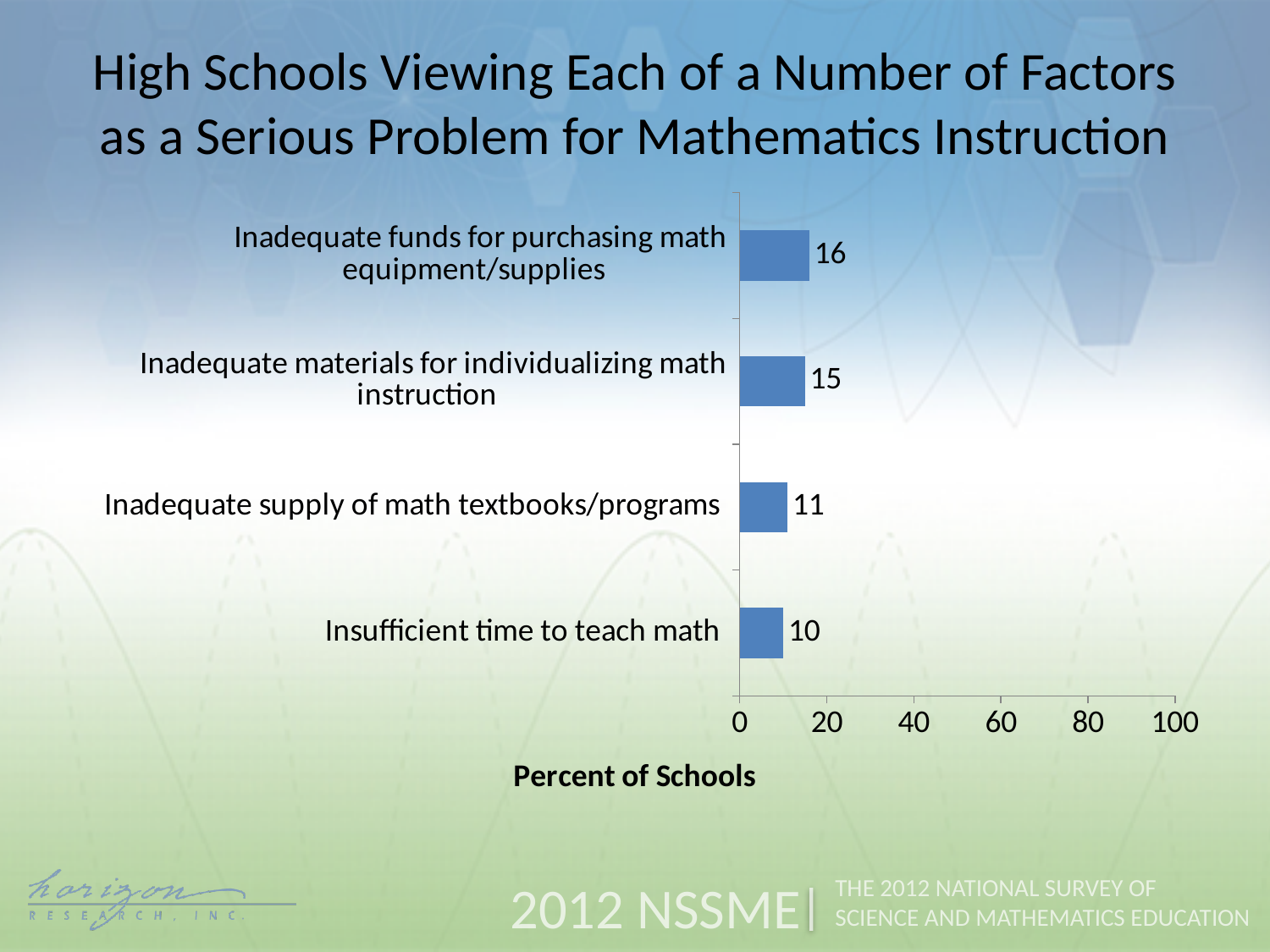
Which is larger: the value for 'Inadequate materials for individualizing math instruction' or 'Inadequate supply of math textbooks/programs'? Inadequate materials for individualizing math instruction Which factor has the lowest percent of schools viewing it as a serious problem? Insufficient time to teach math What is the value for 'Inadequate supply of math textbooks/programs'? 11 What is the label of the horizontal axis? Percent of Schools What is the difference between the values for 'Inadequate funds for purchasing math equipment/supplies' and 'Insufficient time to teach math'? 6 What percent of high schools view inadequate funds for purchasing math equipment/supplies as a serious problem? 16 Is the value for 'Inadequate materials for individualizing math instruction' greater or less than 20? less What is the value for 'Insufficient time to teach math'? 10 Which factor has the highest percent of schools viewing it as a serious problem? Inadequate funds for purchasing math equipment/supplies How many factors are shown in the chart? 4 What kind of chart is shown on the slide? Bar chart What is the maximum value shown on the horizontal axis? 100